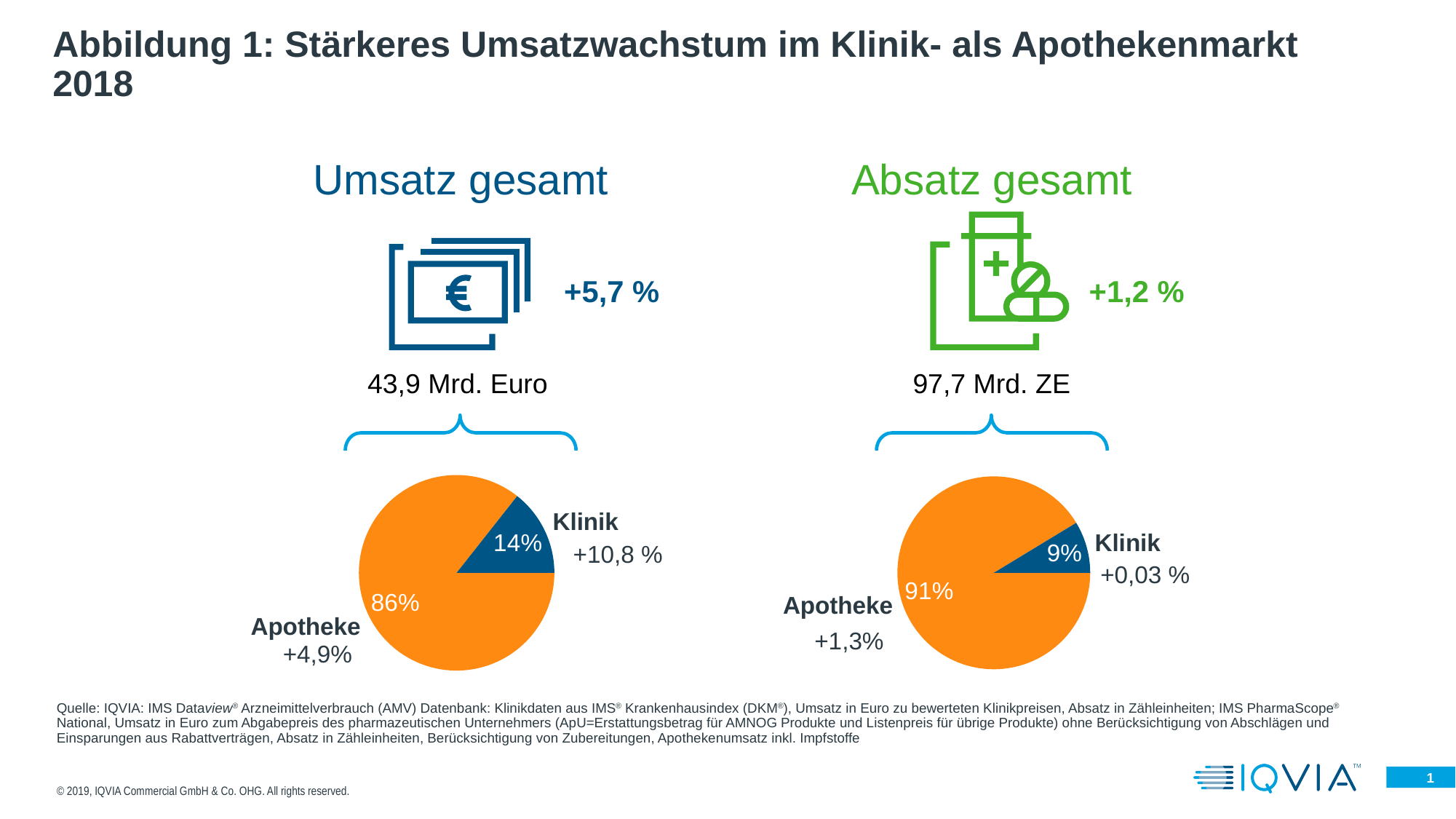
How many segments does the 'Absatz gesamt' pie chart have? 2 In the 'Absatz gesamt' pie chart, which segment is the smallest? Klinik In the 'Absatz gesamt' pie chart, what share does Klinik have? 9% What type of chart is used for 'Umsatz gesamt'? Pie chart In the 'Umsatz gesamt' pie chart, what is the difference in percentage points between the Apotheke and Klinik shares? 72 In the 'Umsatz gesamt' pie chart, what share does Apotheke have? 86% What growth rate is shown next to the Klinik segment in the 'Umsatz gesamt' pie chart? +10,8 % In the 'Umsatz gesamt' pie chart, what share does Klinik have? 14% In the 'Umsatz gesamt' pie chart, which segment is the largest? Apotheke Is the Klinik share larger in the 'Umsatz gesamt' pie chart or in the 'Absatz gesamt' pie chart? Umsatz gesamt In the 'Absatz gesamt' pie chart, what share does Apotheke have? 91% In the 'Absatz gesamt' pie chart, what is the difference in percentage points between the Apotheke and Klinik shares? 82